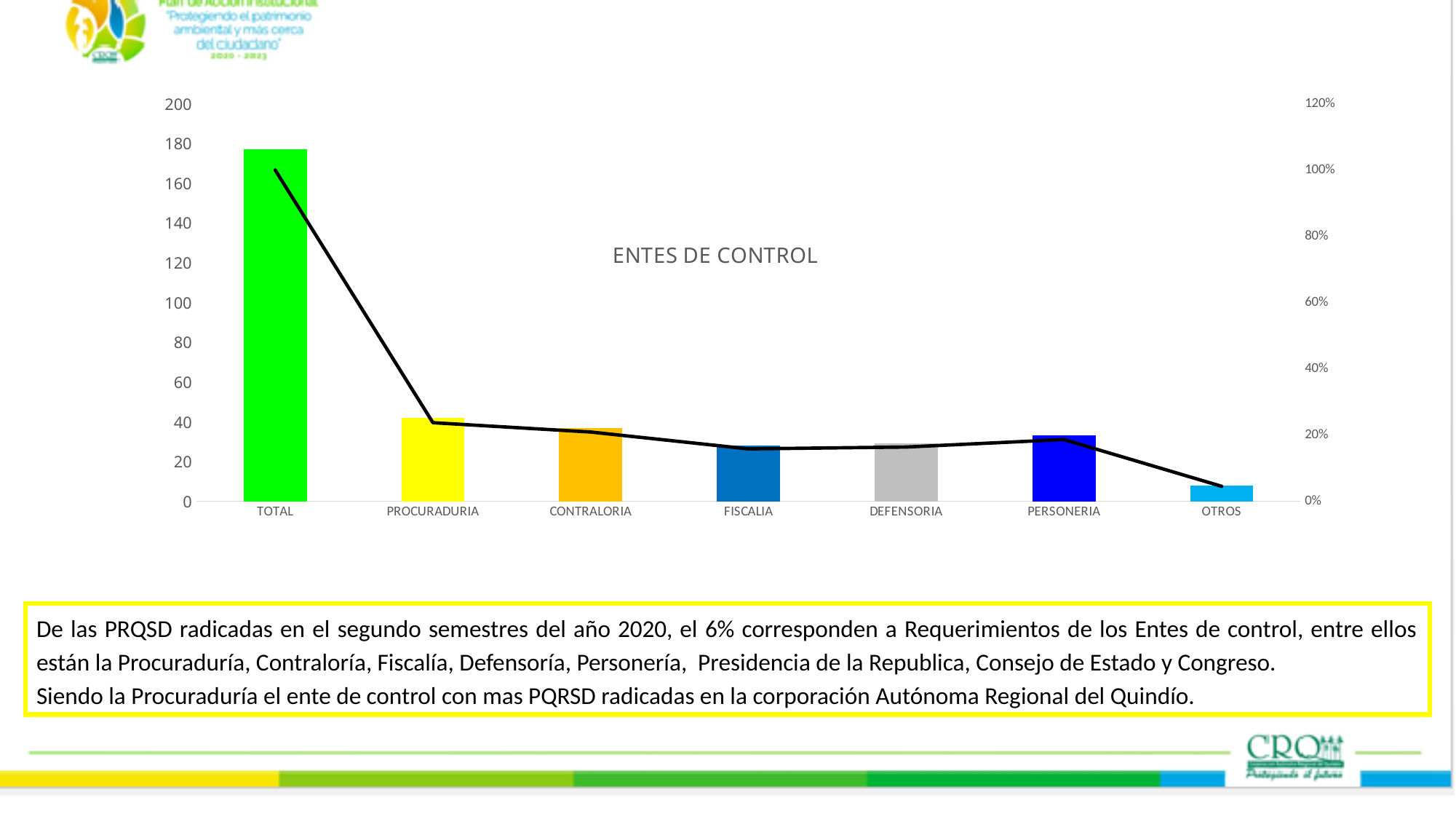
Which category has the tallest bar in the chart? TOTAL What kind of chart is shown on the slide? A bar chart with a line overlaid Which bar is taller, PROCURADURIA or PERSONERIA? PROCURADURIA Which category has the shortest bar in the chart? OTROS Is the bar value for PERSONERIA greater or less than 20? greater What is the title shown on the chart? ENTES DE CONTROL Is the bar value for PROCURADURIA greater or less than 60? less At which category does the black line reach its highest point? TOTAL How many categories are shown on the x axis of the chart? 7 Is the bar value for OTROS greater or less than 20? less Which bar is taller, CONTRALORIA or OTROS? CONTRALORIA